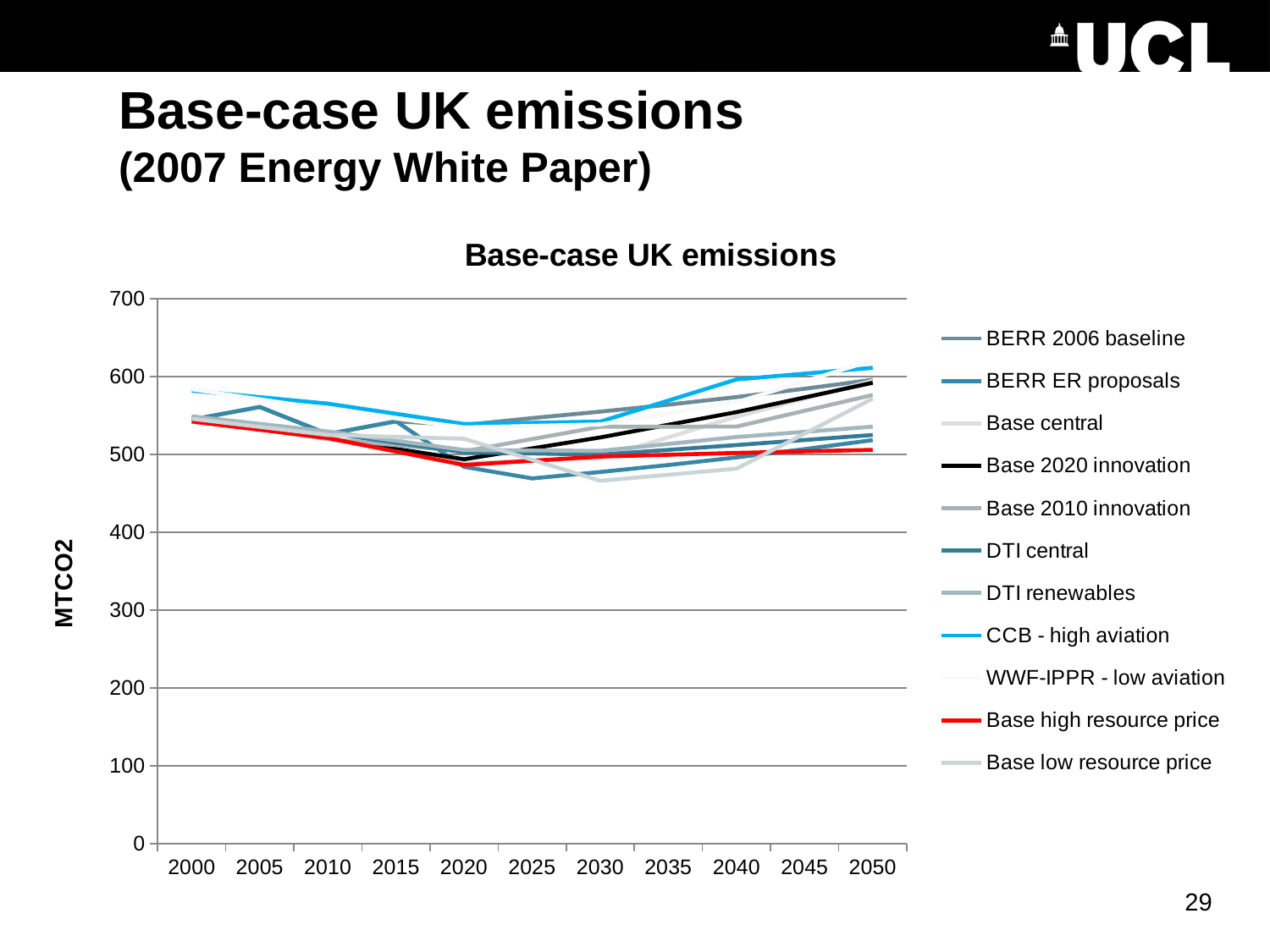
Is the value for CCB - high aviation in 2050 greater or less than 600? greater Which series has the highest value in 2050? WWF-IPPR - low aviation What is the label on the y axis? MTCO2 Which series has the lowest value in 2050? Base high resource price How many years are labelled along the x axis? 11 Does the CCB - high aviation line rise or fall between 2020 and 2050? rise How many series does the legend list? 11 What kind of chart is shown on the slide? line chart Is the value for Base low resource price in 2030 greater or less than 500? less Is the value for Base high resource price in 2050 greater or less than 600? less What is the title of the chart? Base-case UK emissions